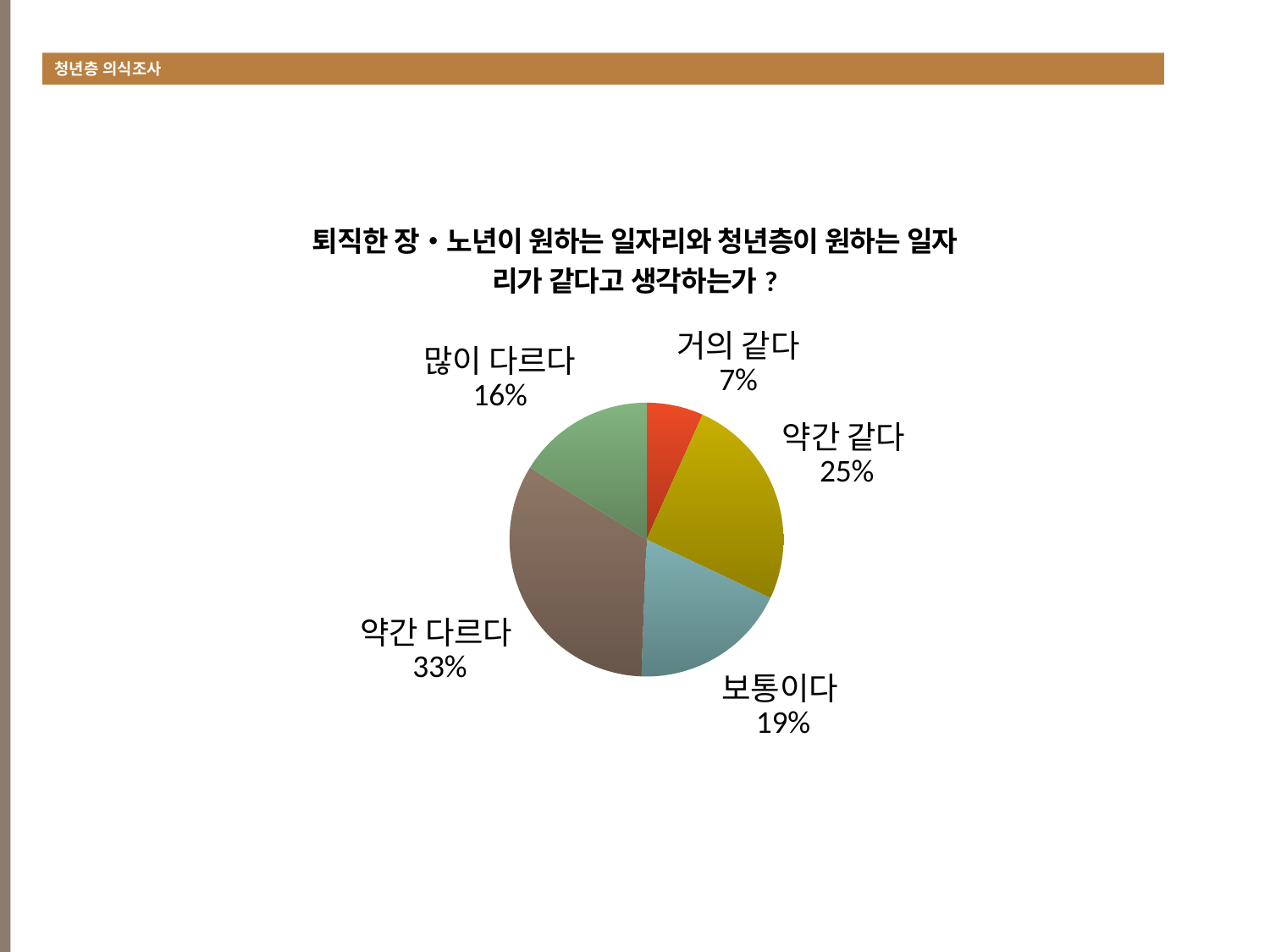
Which is larger, the share for 보통이다 or the share for 많이 다르다? 보통이다 How many response categories are shown in the pie chart? 5 What percentage of respondents answered 많이 다르다? 16% What percentage of respondents answered 약간 다르다? 33% What is the difference in percentage points between 약간 다르다 and 약간 같다? 8 What percentage of respondents answered 보통이다? 19% What percentage of respondents answered 거의 같다? 7% What colour is the slice for 약간 같다? yellow What percentage of respondents answered 약간 같다? 25% Which response has the largest share of the pie? 약간 다르다 Which response has the smallest share of the pie? 거의 같다 What type of chart is shown on the slide? pie chart